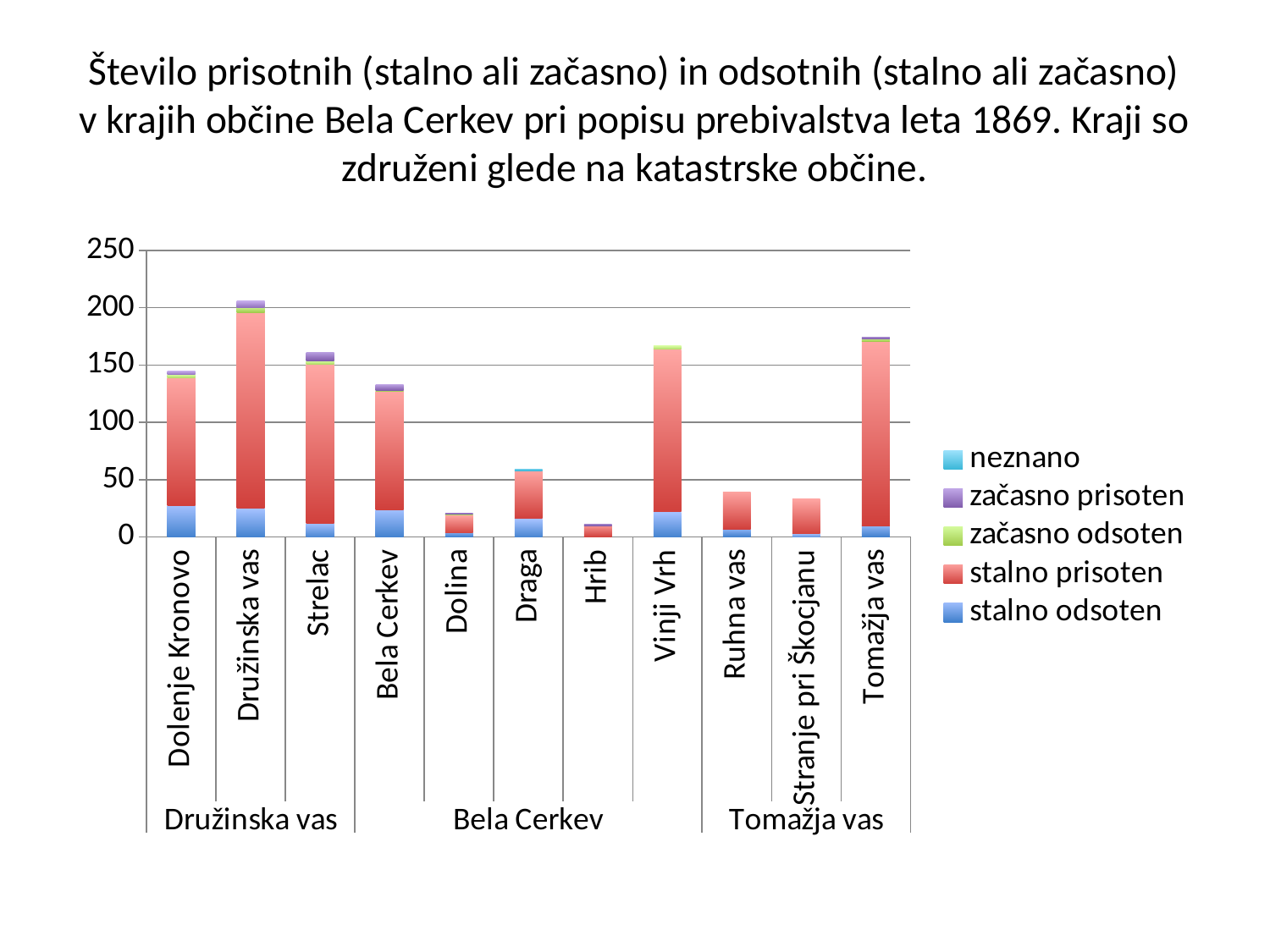
Which has the taller stacked bar, Strelac or Bela Cerkev? Strelac How many places (bars) are plotted on the chart? 11 Which series is shown in red in the legend? stalno prisoten Which has the taller stacked bar, Draga or Dolina? Draga Is the total for Stranje pri Škocjanu greater or less than 50? less Is the total for Dolenje Kronovo greater or less than 100? greater How many series does the legend list? 5 Which place has the tallest stacked bar? Družinska vas What kind of chart is shown on the slide? stacked bar chart Is the total for Vinji Vrh greater or less than 150? greater Which place has the shortest stacked bar? Hrib